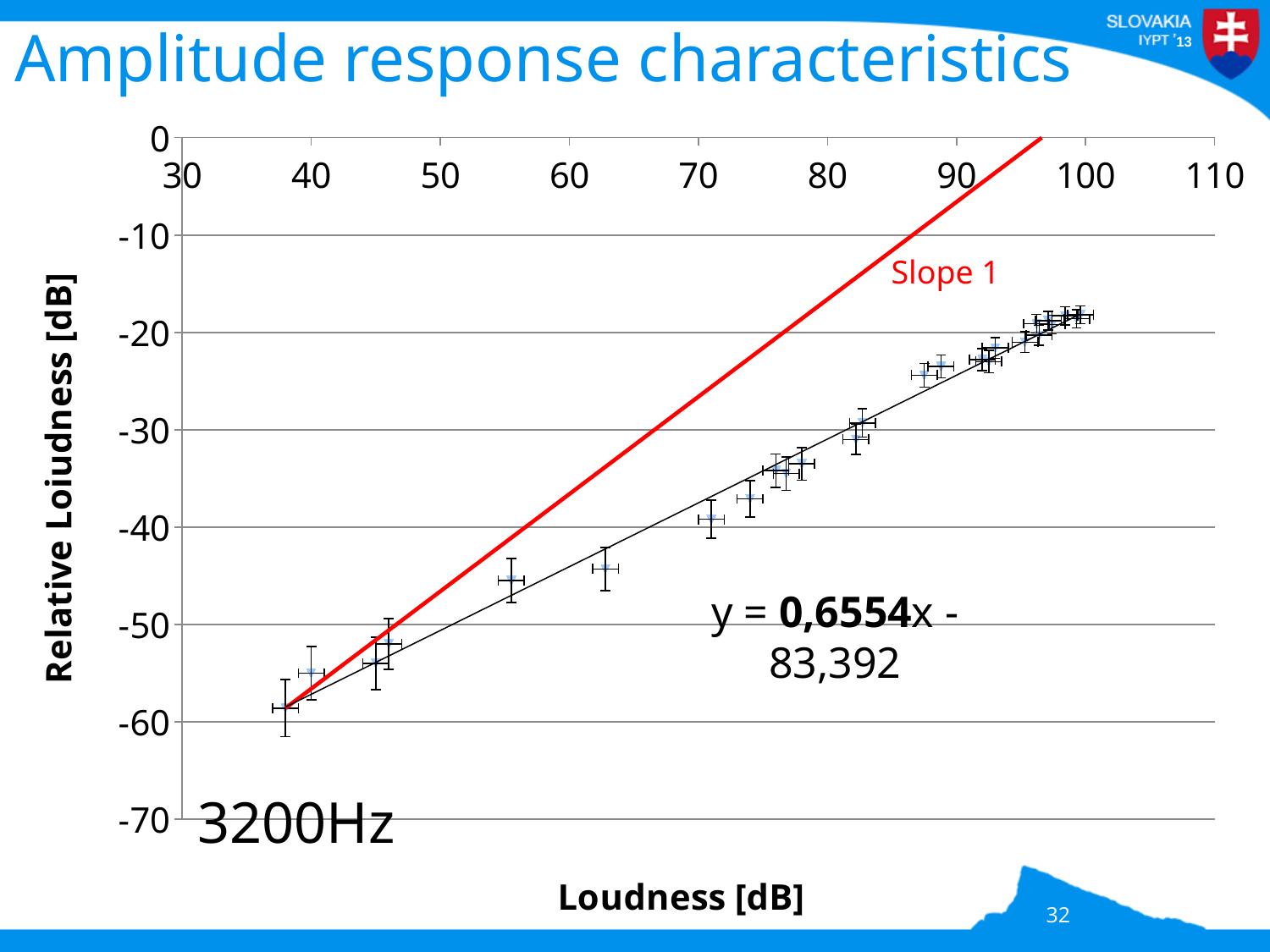
Which data point has the lowest Relative Loudness: the one near 38 dB Loudness or the one near 100 dB Loudness? the one near 38 dB What is the intercept in the fitted-line equation shown on the chart? -83,392 What kind of chart is shown on the slide? scatter plot Is the Relative Loudness value for the data point near 70 dB Loudness greater or less than -30? less What frequency is annotated on the chart? 3200Hz What is the label of the x axis? Loudness [dB] Is the Relative Loudness value for the lowest-loudness data point (near 38 dB) greater or less than -50? less Is the Relative Loudness value for the data points near 100 dB Loudness greater or less than -20? greater What is the slope of the fitted line shown in the equation on the chart? 0,6554 Do the plotted values rise or fall as Loudness increases along the x axis? rise